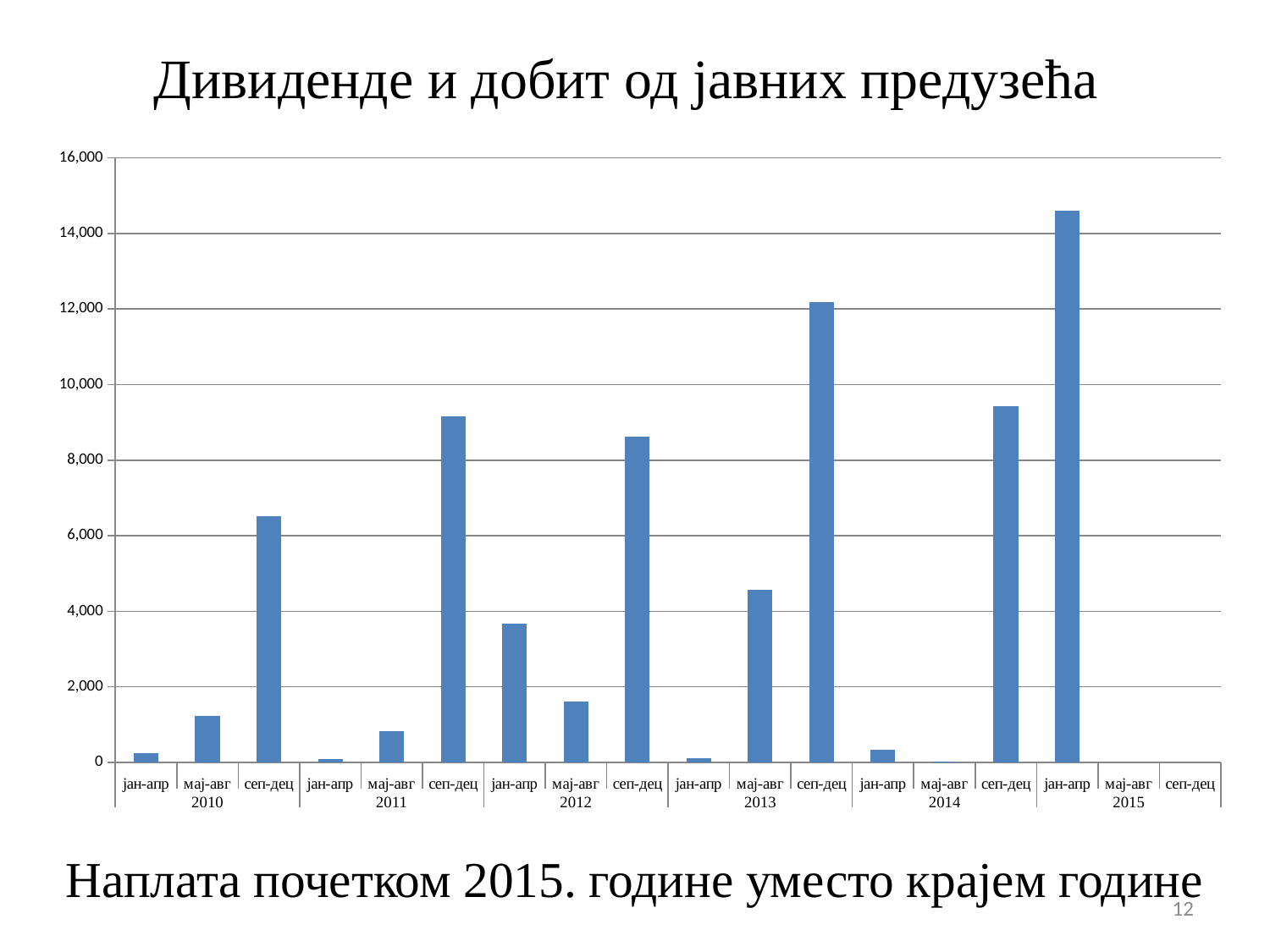
Which is larger, the value for јан-апр 2012 or the value for мај-авг 2012? јан-апр 2012 Is the value for јан-апр 2015 greater or less than 14,000? greater Which is larger, the value for сеп-дец 2013 or the value for сеп-дец 2012? сеп-дец 2013 What is the title of the chart? Дивиденде и добит од јавних предузећа How many years are labelled along the x axis of the chart? 6 Is the value for сеп-дец 2013 greater or less than 10,000? greater Which period has the highest value in the chart? јан-апр 2015 Is the value for мај-авг 2012 greater or less than 2,000? less What kind of chart is shown on the slide? bar chart How many bars (period categories) are shown along the x axis of the chart? 18